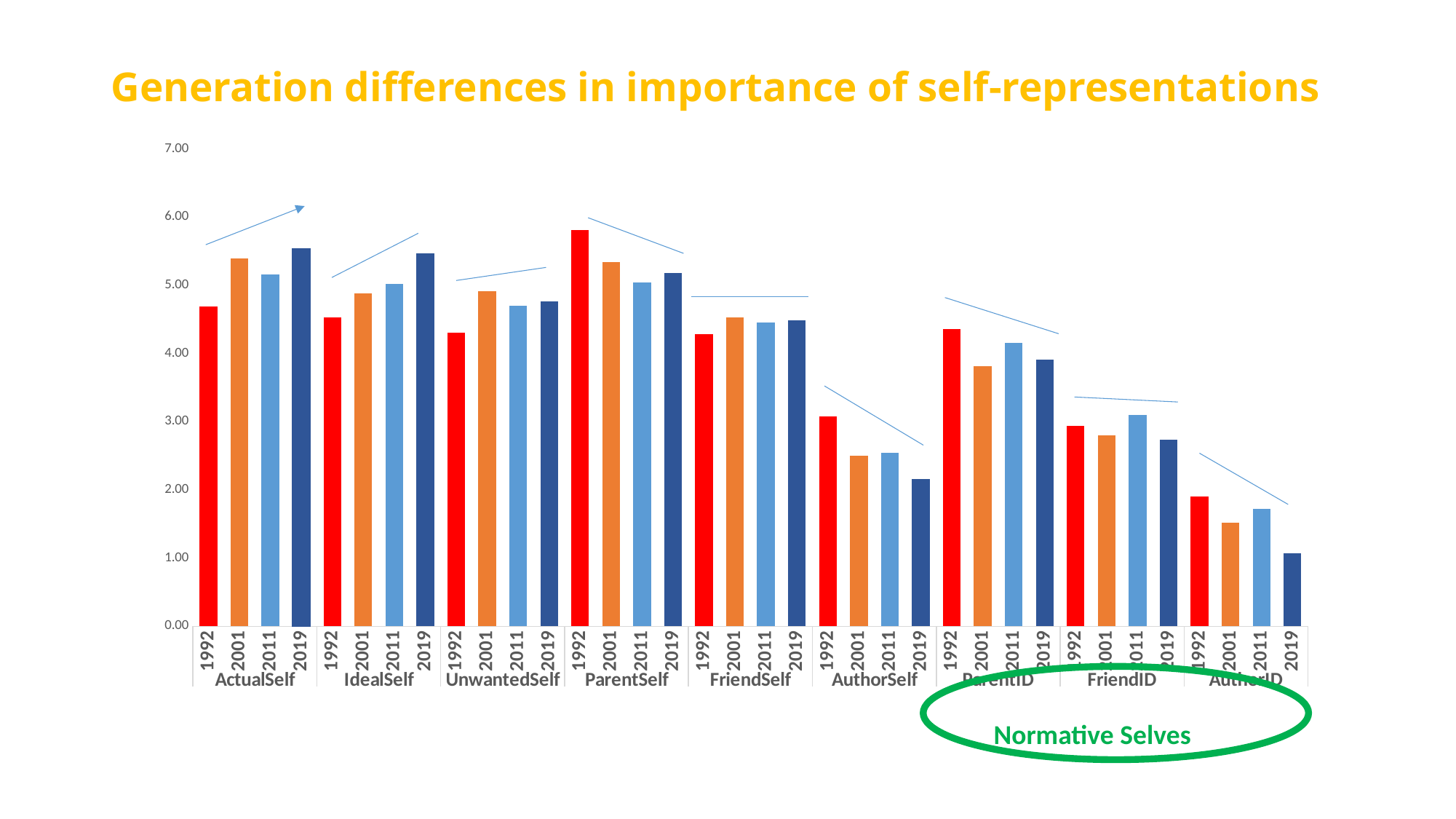
How many self-representation categories are shown along the x axis? 9 Is the value for ActualSelf in 2019 greater or less than 5.00? greater How many bars are plotted for each self-representation category? 4 Which self-representation category and year has the tallest bar in the chart? ParentSelf, 1992 Is the value for AuthorID in 2019 greater or less than 2.00? less What kind of chart is shown on the slide? bar chart Do the values for AuthorID generally rise or fall from 1992 to 2019? fall What is the title of the chart on the slide? Generation differences in importance of self-representations Which is larger, the value for IdealSelf in 1992 or the value for IdealSelf in 2019? IdealSelf in 2019 Which is larger, the value for ParentSelf in 1992 or the value for ParentSelf in 2019? ParentSelf in 1992 Which self-representation category and year has the shortest bar in the chart? AuthorID, 2019